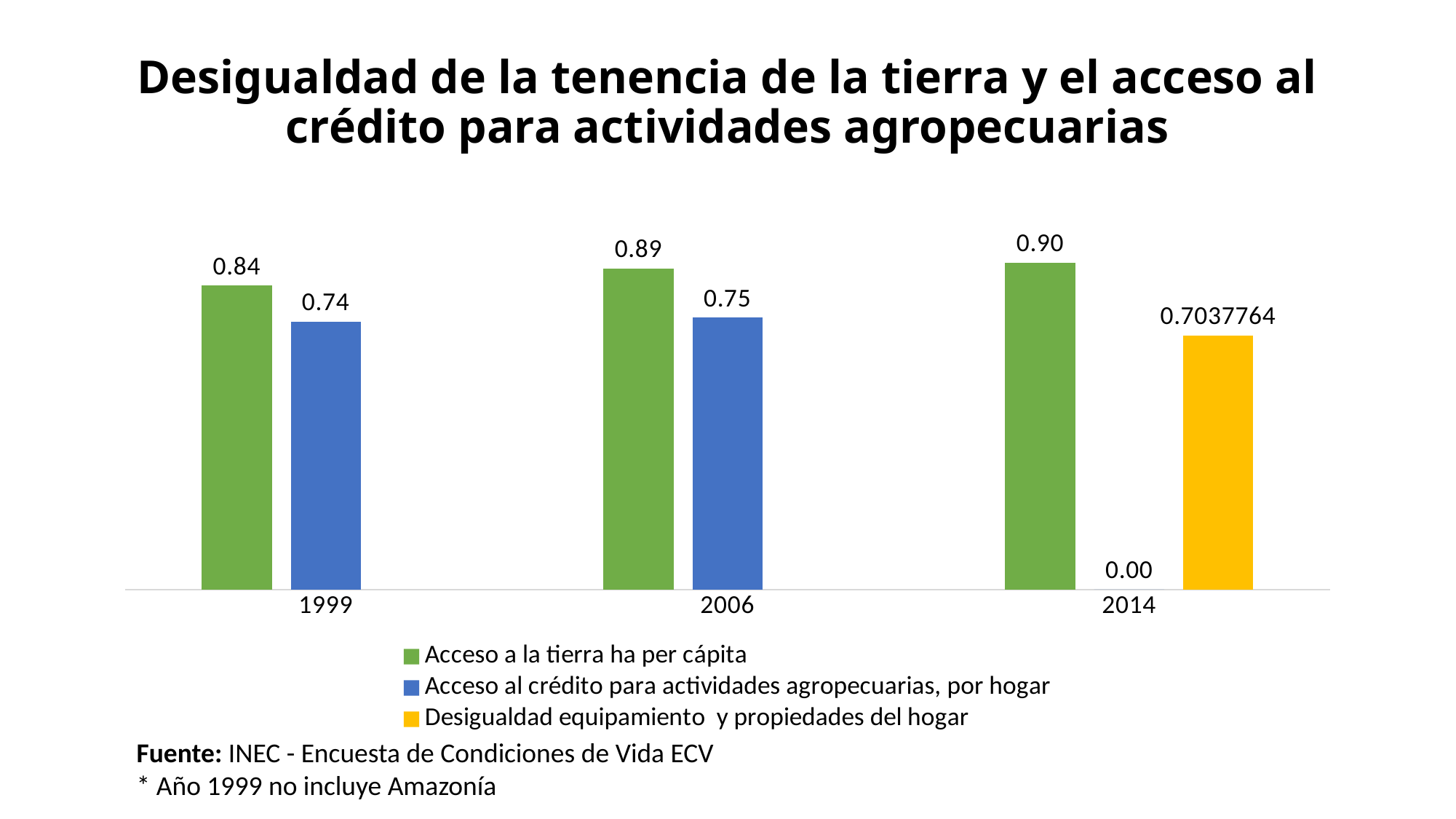
What is the value of 'Desigualdad equipamiento y propiedades del hogar' in 2014? 0.7037764 What is the value of 'Acceso a la tierra ha per cápita' in 1999? 0.84 What is the difference between 'Acceso a la tierra ha per cápita' and 'Acceso al crédito para actividades agropecuarias, por hogar' in 1999? 0.10 How many series does the legend list? 3 In which year is 'Acceso a la tierra ha per cápita' lowest? 1999 What kind of chart is shown on the slide? Bar chart What is the value of 'Acceso al crédito para actividades agropecuarias, por hogar' in 2006? 0.75 Does 'Acceso a la tierra ha per cápita' rise or fall from 1999 to 2014? Rise Which is larger in 2006: 'Acceso a la tierra ha per cápita' or 'Acceso al crédito para actividades agropecuarias, por hogar'? Acceso a la tierra ha per cápita What is the value of 'Acceso al crédito para actividades agropecuarias, por hogar' in 2014? 0.00 How many years are shown on the x axis? 3 In which year is 'Acceso a la tierra ha per cápita' highest? 2014